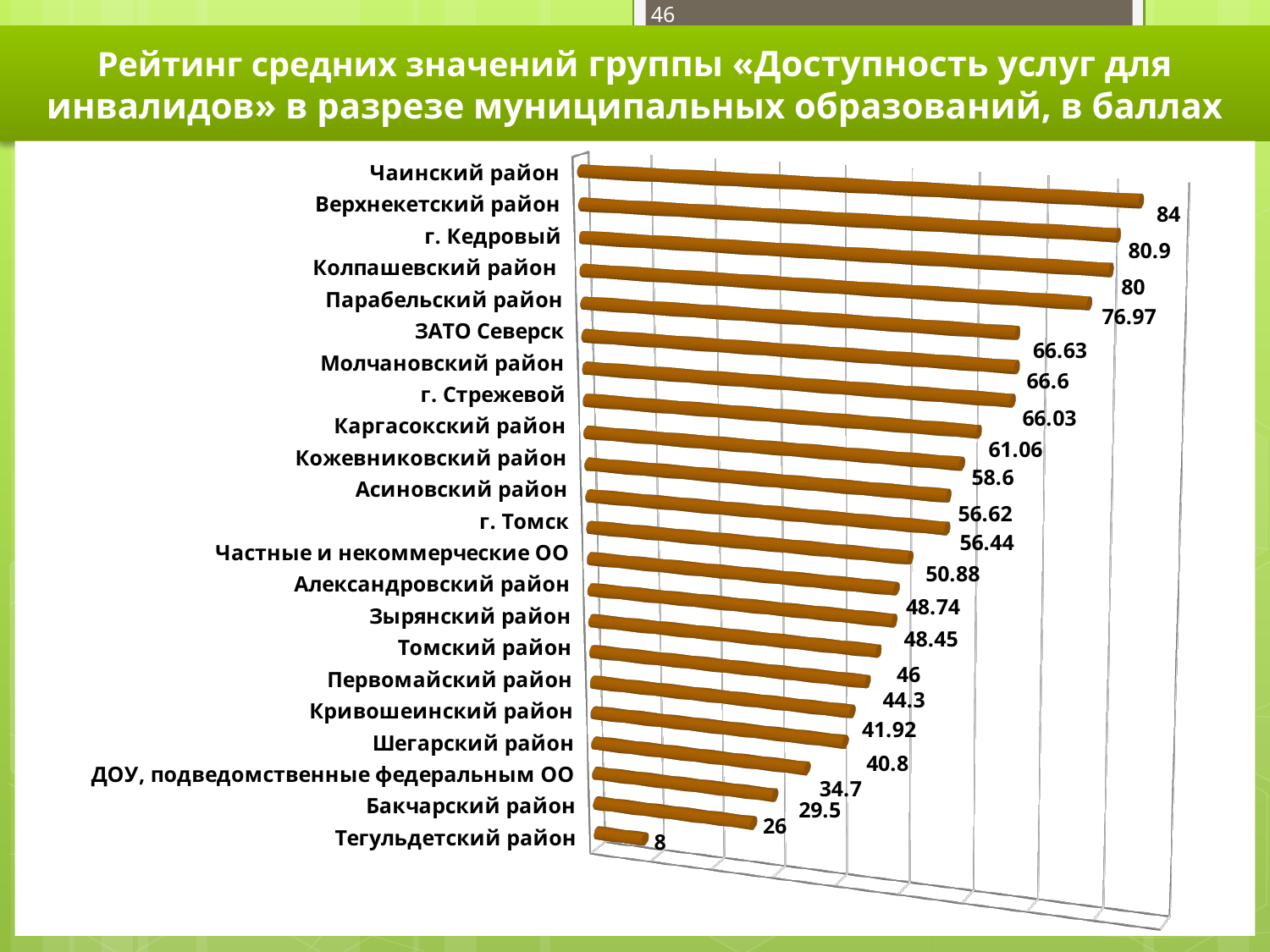
Do the values rise or fall going from the top category to the bottom category? fall What is the value for Тегульдетский район? 8 How many municipalities (categories) are shown in the chart? 22 What type of chart is shown on the slide? bar chart What is the value for Чаинский район? 84 What is the difference between the values for Верхнекетский район and г. Кедровый? 0.9 What is the value for ЗАТО Северск? 66.6 What is the difference between the values for Чаинский район and Тегульдетский район? 76 Which municipality has the lowest value? Тегульдетский район Which municipality has the highest value? Чаинский район Which has a larger value, Бакчарский район or Шегарский район? Шегарский район What is the value for г. Томск? 50.88